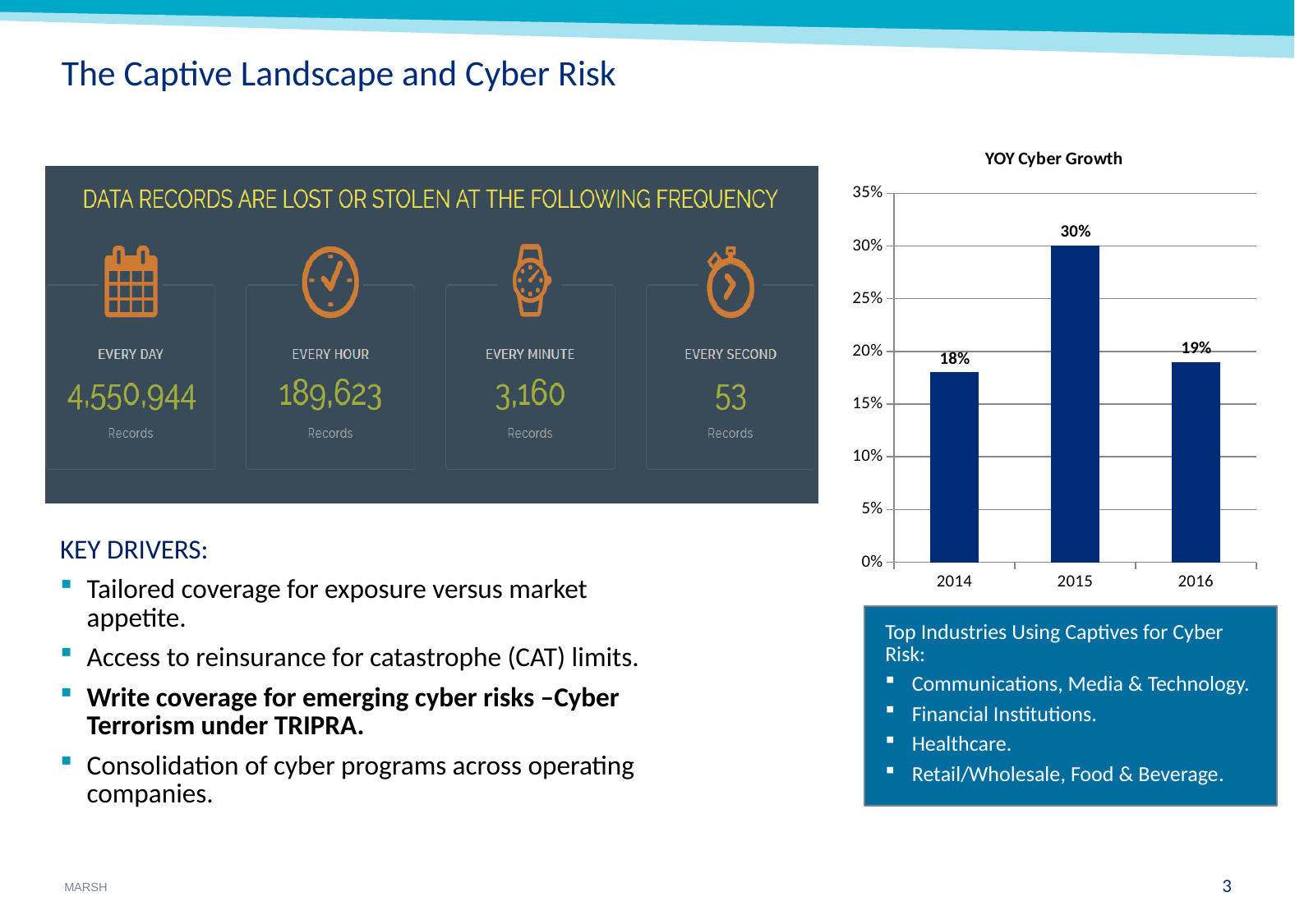
Which year has the highest YOY Cyber Growth? 2015 What is the YOY Cyber Growth value for 2015? 30% What is the title of the chart on the right side of the slide? YOY Cyber Growth What kind of chart is the YOY Cyber Growth chart? bar chart How many years are shown on the YOY Cyber Growth chart? 3 Is the YOY Cyber Growth value for 2015 greater or less than 25%? greater What is the difference between the YOY Cyber Growth values for 2015 and 2016? 11% Is the YOY Cyber Growth value for 2014 greater or less than 20%? less Which year has the lowest YOY Cyber Growth? 2014 What is the YOY Cyber Growth value for 2014? 18% What is the YOY Cyber Growth value for 2016? 19% What is the difference between the YOY Cyber Growth values for 2015 and 2014? 12%